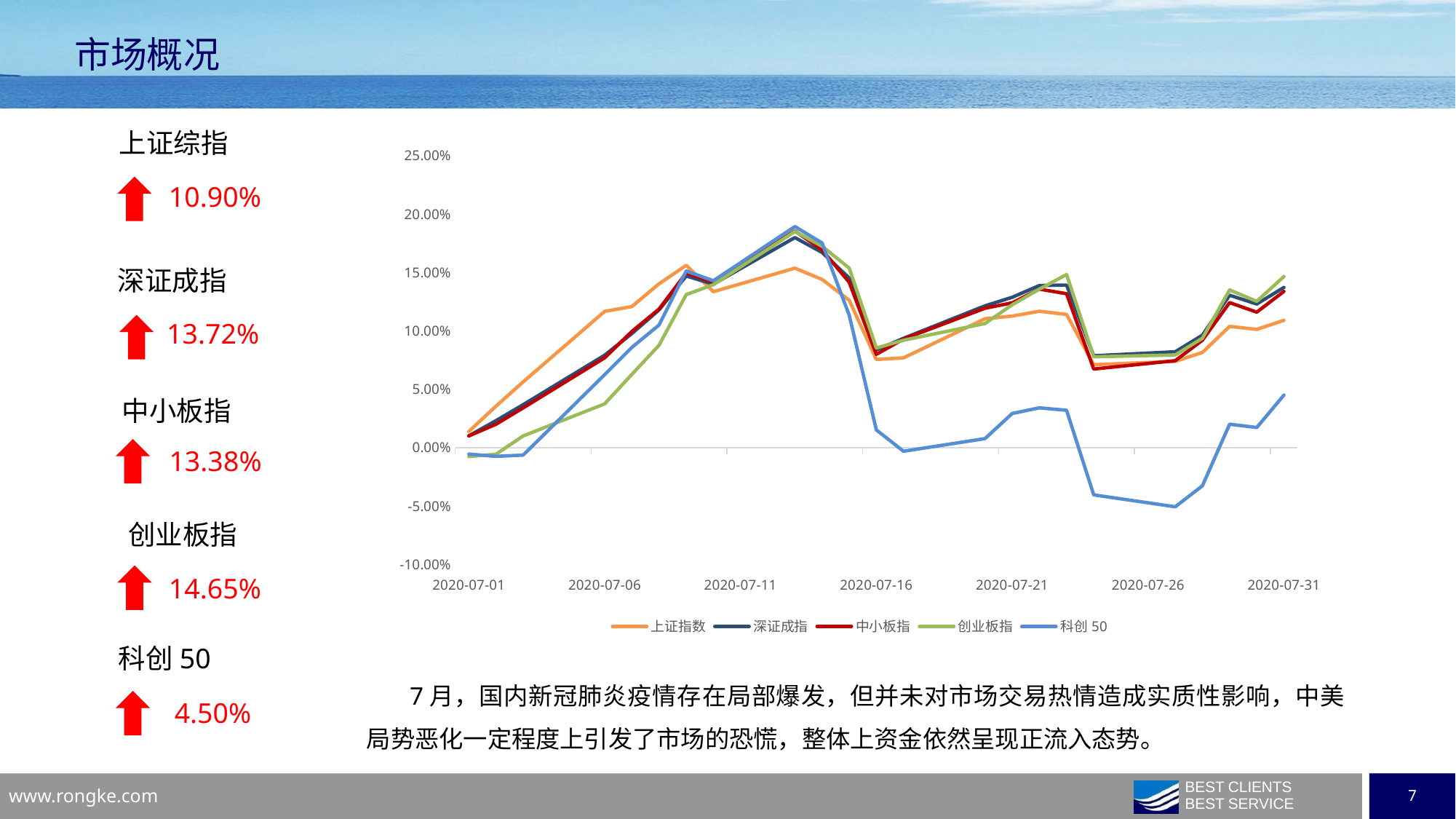
Does the 科创 50 line rise or fall between 2020-07-01 and 2020-07-11? rise What kind of chart is shown on the slide? line chart How many series does the chart legend list? 5 What is the first date shown on the x axis? 2020-07-01 Is the value for 上证指数 at 2020-07-31 greater or less than 10.00%? greater Which series is lowest at 2020-07-26? 科创 50 At 2020-07-31, which is higher: 上证指数 or 创业板指? 创业板指 Is the value for 科创 50 at 2020-07-01 greater or less than 5.00%? less Is the value for 创业板指 at 2020-07-31 greater or less than 10.00%? greater What colour is the 科创 50 line in the legend? blue Which series is lowest at 2020-07-31? 科创 50